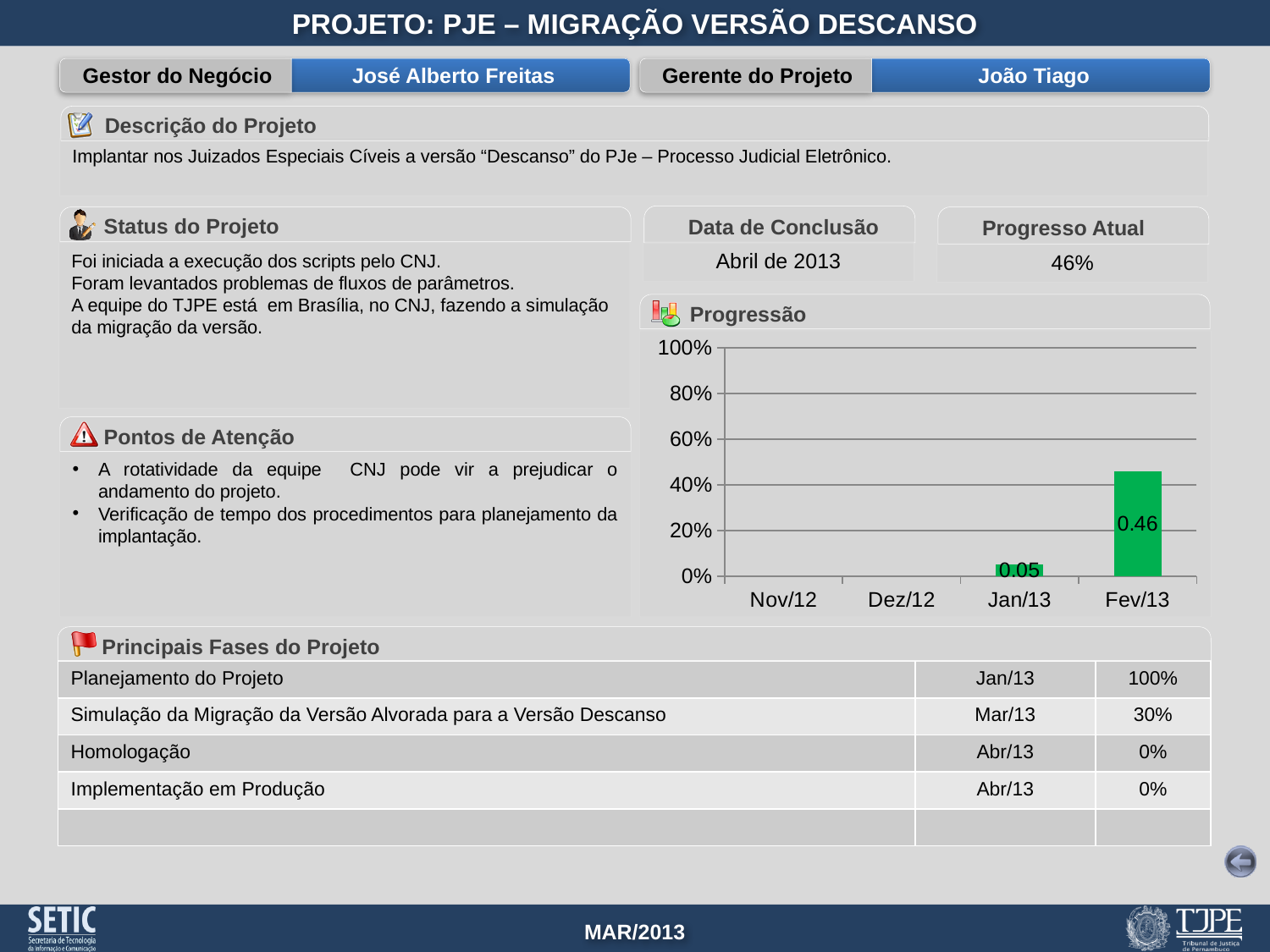
What type of chart is shown under "Progressão"? bar chart In the "Progressão" chart, what is the difference between the labelled values for Fev/13 and Jan/13? 0.41 In the "Progressão" chart, which is larger, the value for Jan/13 or the value for Fev/13? Fev/13 In the "Progressão" chart, what is the value labelled for Jan/13? 0.05 In the "Progressão" chart, is the bar for Fev/13 greater or less than 40%? greater In the "Progressão" chart, which month has the highest bar? Fev/13 What colour are the bars in the "Progressão" chart? green In the "Progressão" chart, is the bar for Jan/13 greater or less than 20%? less In the "Progressão" chart, what is the value labelled for Fev/13? 0.46 How many months are labelled on the x axis of the "Progressão" chart? 4 In the "Progressão" chart, do the values rise or fall from Jan/13 to Fev/13? rise What is the highest value shown on the y axis of the "Progressão" chart? 100%